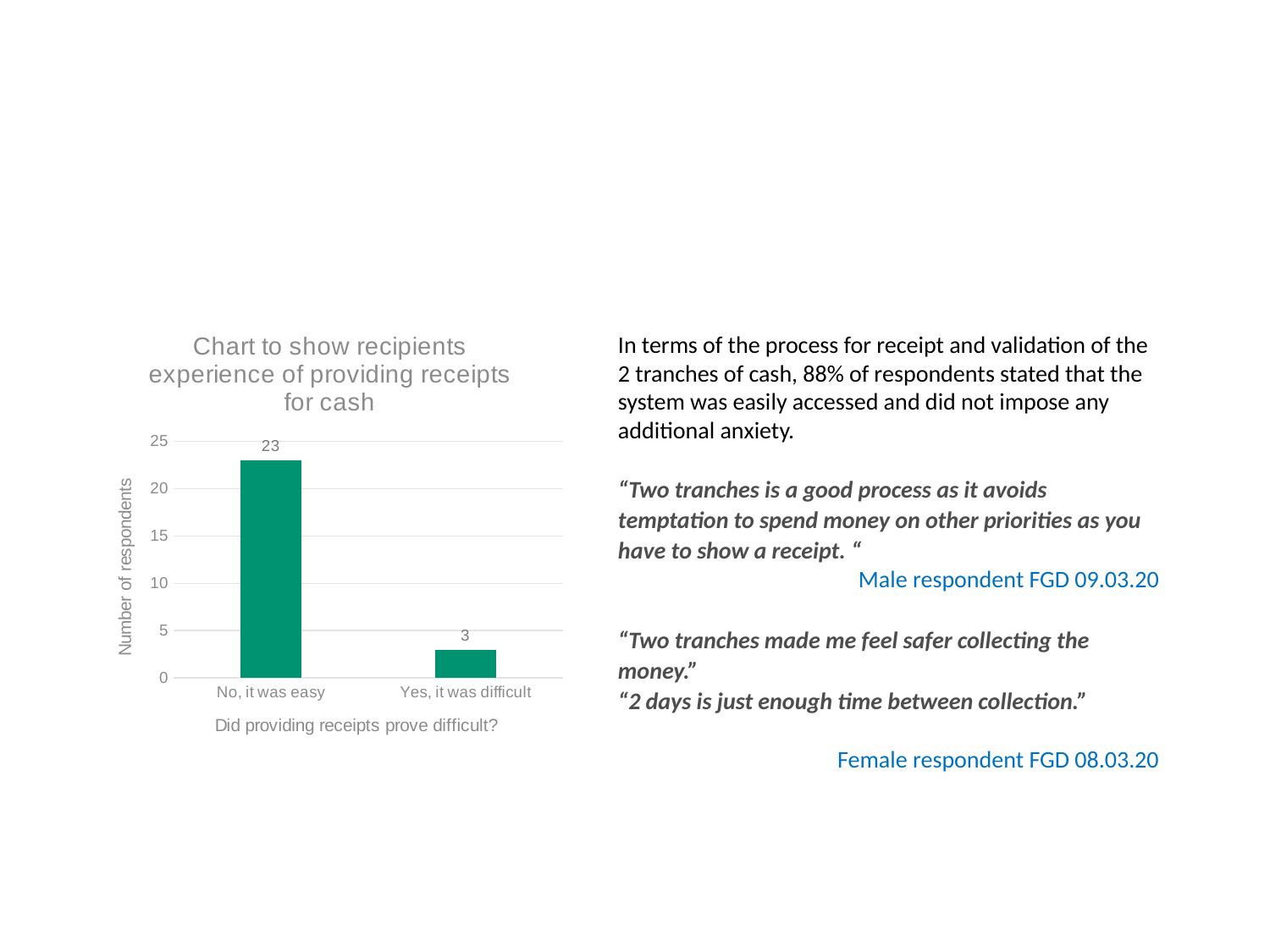
What is the label of the vertical axis of the chart? Number of respondents How many respondents answered "No, it was easy"? 23 Which category has the lowest number of respondents? Yes, it was difficult Which has more respondents: "No, it was easy" or "Yes, it was difficult"? No, it was easy How many categories are shown on the chart? 2 What is the difference in number of respondents between "No, it was easy" and "Yes, it was difficult"? 20 Which category has the highest number of respondents? No, it was easy How many respondents answered "Yes, it was difficult"? 3 Is the value for "Yes, it was difficult" greater or less than 5? less Is the value for "No, it was easy" greater or less than 20? greater What kind of chart is shown on the slide? Bar chart What is the title of the chart? Chart to show recipients experience of providing receipts for cash